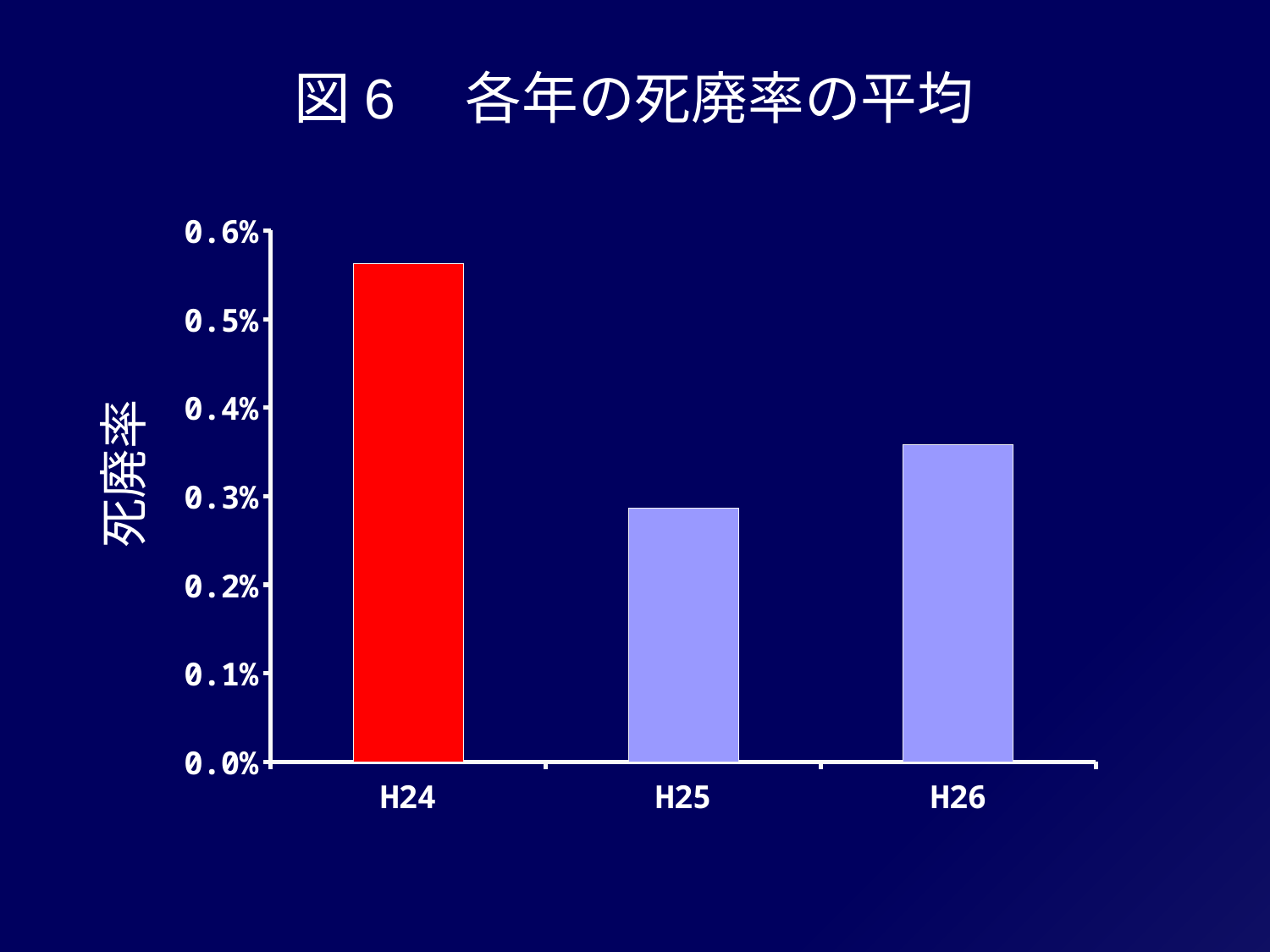
Is the value for H24 greater or less than 0.5%? greater Is the value for H26 greater or less than 0.3%? greater Which is larger, the value for H24 or the value for H26? H24 Which year has the highest 死廃率? H24 What is the title of the chart? 図６ 各年の死廃率の平均 Is the value for H26 greater or less than 0.4%? less What kind of chart is shown on the slide? bar chart Which year has the lowest 死廃率? H25 Which bar is coloured red? H24 Which is larger, the value for H25 or the value for H26? H26 How many categories are shown on the x axis? 3